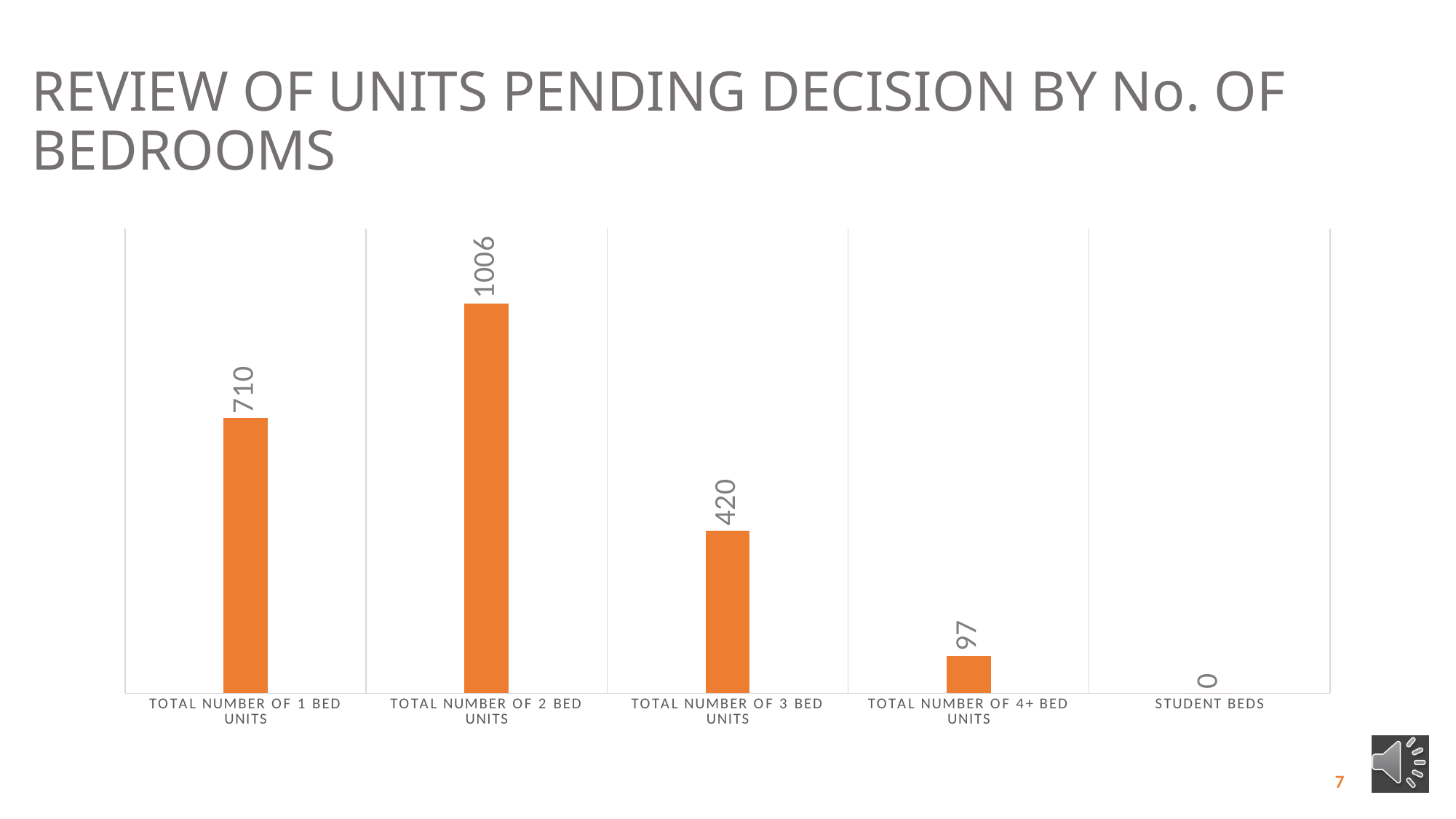
What is the value for Total Number of 3 Bed Units? 420 Which category has the lowest value? Student Beds What is the value for Total Number of 4+ Bed Units? 97 What is the value for Total Number of 2 Bed Units? 1006 What kind of chart is shown on the slide? Bar chart How many categories are shown on the chart? 5 What is the value for Total Number of 1 Bed Units? 710 What is the difference between the values for Total Number of 2 Bed Units and Total Number of 1 Bed Units? 296 What is the difference between the values for Total Number of 3 Bed Units and Total Number of 4+ Bed Units? 323 Which is larger, the value for Total Number of 1 Bed Units or Total Number of 3 Bed Units? Total Number of 1 Bed Units Which category has the highest value? Total Number of 2 Bed Units What is the value for Student Beds? 0